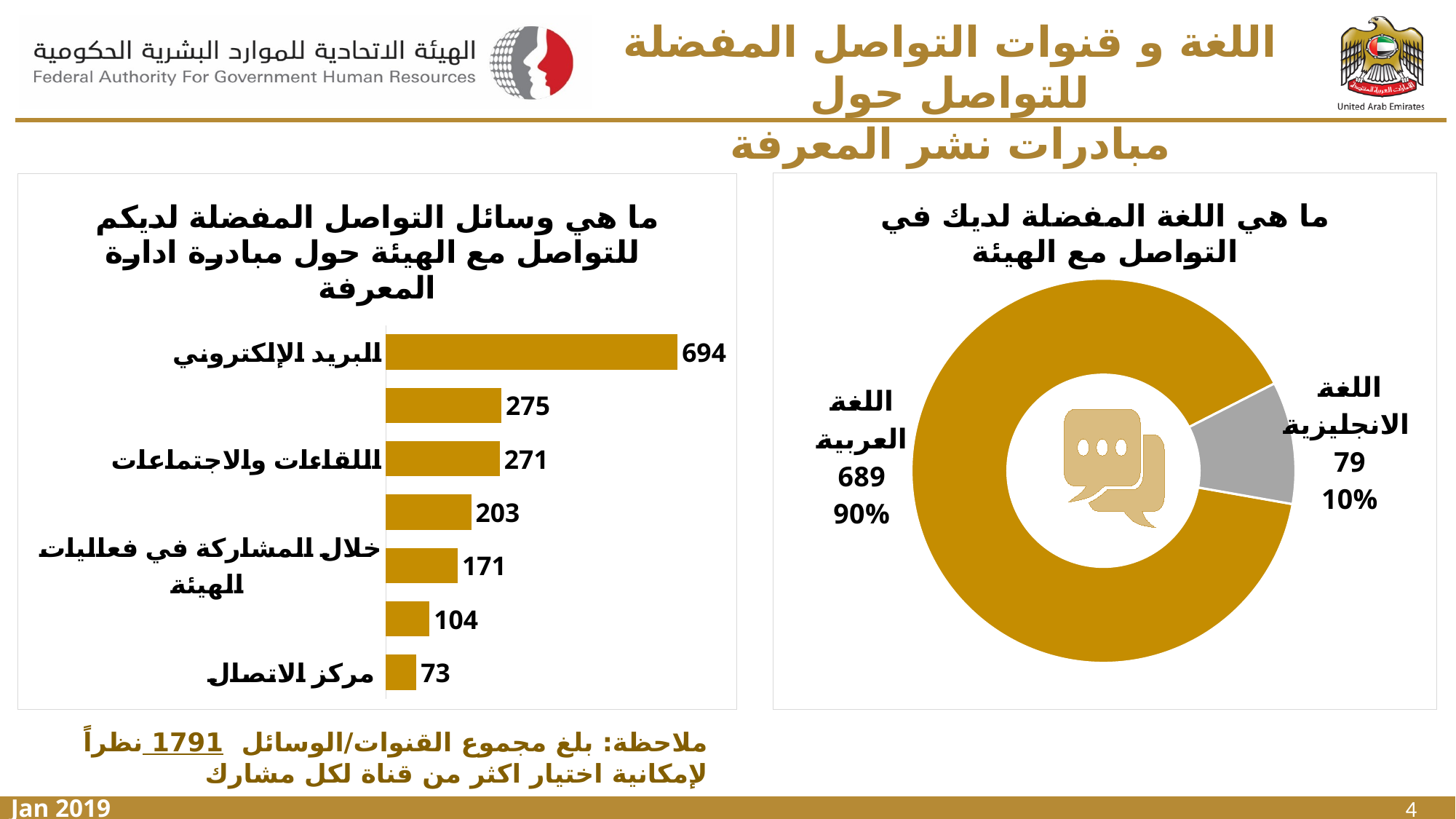
In the bar chart on the left, what is the value for البريد الإلكتروني? 694 In the donut chart on the right, which language has the larger value, اللغة العربية or اللغة الانجليزية? اللغة العربية In the donut chart on the right, what is the difference between the values for اللغة العربية and اللغة الانجليزية? 610 What kind of chart is shown on the left side of the slide? Bar chart In the donut chart on the right, what share does اللغة الانجليزية have? 10% In the bar chart on the left, what is the difference between the values for البريد الإلكتروني and مركز الاتصال? 621 In the donut chart on the right, what is the value for اللغة العربية? 689 In the bar chart on the left, how many bars are plotted? 7 In the bar chart on the left, what is the value for مركز الاتصال? 73 In the bar chart on the left, what is the value for اللقاءات والاجتماعات? 271 In the bar chart on the left, which category has the highest value? البريد الإلكتروني In the bar chart on the left, which category has the lowest value? مركز الاتصال